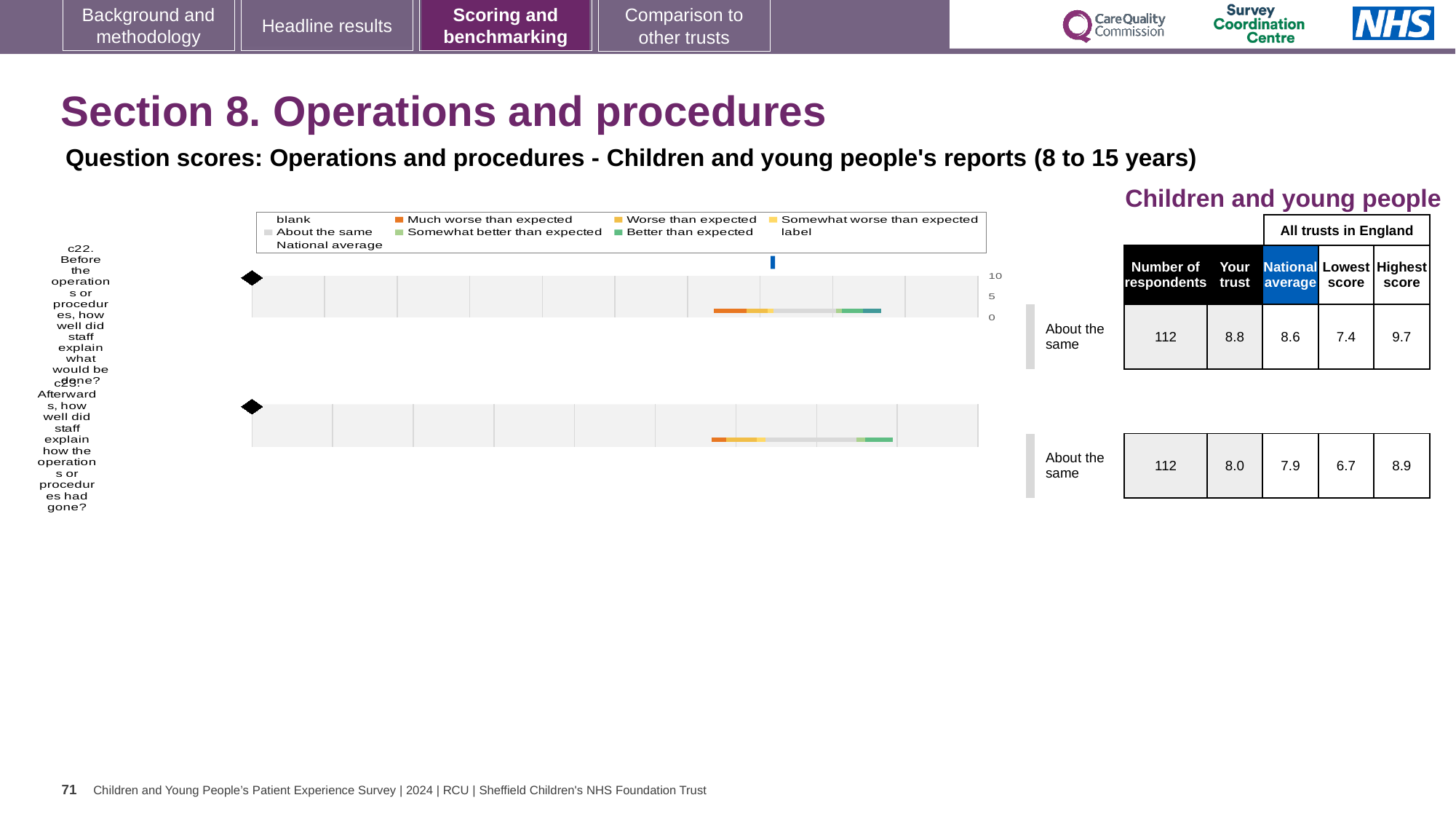
How many questions (categories) are plotted in the benchmarking charts on this slide? 2 What is the highest score across all trusts in England for c22? 9.7 Which legend entry is shown in orange? Much worse than expected What is the 'Your trust' score for c22 (Before the operations or procedures, how well did staff explain what would be done?)? 8.8 What kind of chart is used to show the question scores on this slide? bar chart What is the lowest score across all trusts in England for c23? 6.7 What benchmark category is shown next to the chart for question c22? About the same What is the national average score for c23 (Afterwards, how well did staff explain how the operations or procedures had gone?)? 7.9 Which question has the higher 'Your trust' score, c22 or c23? c22 What benchmark category is shown next to the chart for question c23? About the same How many entries does the chart legend list? 9 How many respondents answered question c22? 112